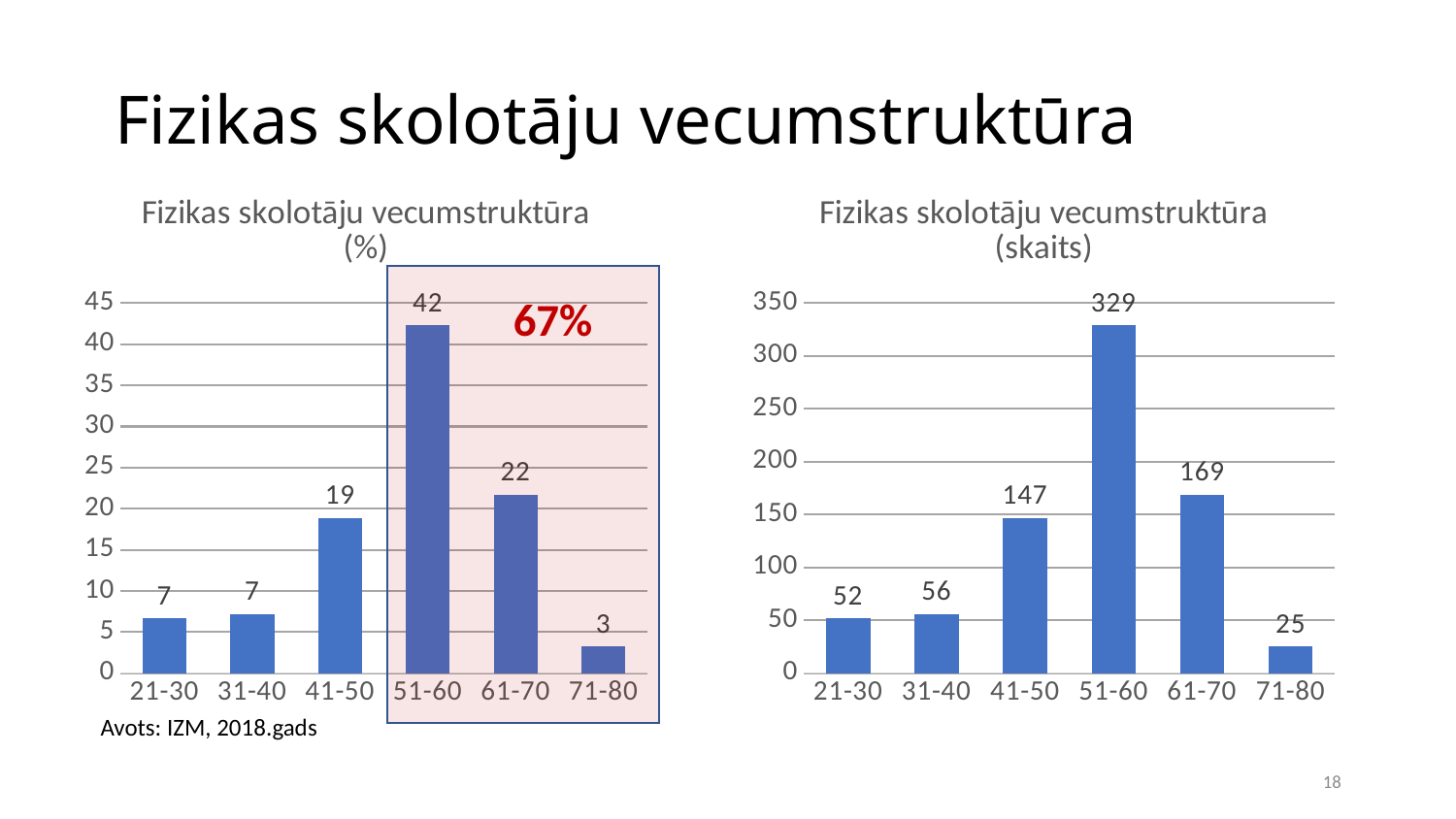
In the chart titled 'Fizikas skolotāju vecumstruktūra (skaits)', what is the value for the 41-50 age group? 147 How many age groups are shown in the chart titled 'Fizikas skolotāju vecumstruktūra (%)'? 6 What kind of chart is the chart titled 'Fizikas skolotāju vecumstruktūra (skaits)'? bar chart In the chart titled 'Fizikas skolotāju vecumstruktūra (%)', what percentage is printed in red inside the highlighted box? 67% In the chart titled 'Fizikas skolotāju vecumstruktūra (%)', what is the value for the 51-60 age group? 42 In the chart titled 'Fizikas skolotāju vecumstruktūra (skaits)', what is the difference between the values for 51-60 and 61-70? 160 In the chart titled 'Fizikas skolotāju vecumstruktūra (skaits)', which age group has the highest value? 51-60 In the chart titled 'Fizikas skolotāju vecumstruktūra (%)', which age group has the lowest value? 71-80 In the chart titled 'Fizikas skolotāju vecumstruktūra (%)', what is the difference between the values for 41-50 and 61-70? 3 In the chart titled 'Fizikas skolotāju vecumstruktūra (skaits)', what is the value for the 71-80 age group? 25 In the chart titled 'Fizikas skolotāju vecumstruktūra (skaits)', is the value for 61-70 greater or less than 150? greater In the chart titled 'Fizikas skolotāju vecumstruktūra (skaits)', which is larger, the value for 21-30 or the value for 31-40? 31-40